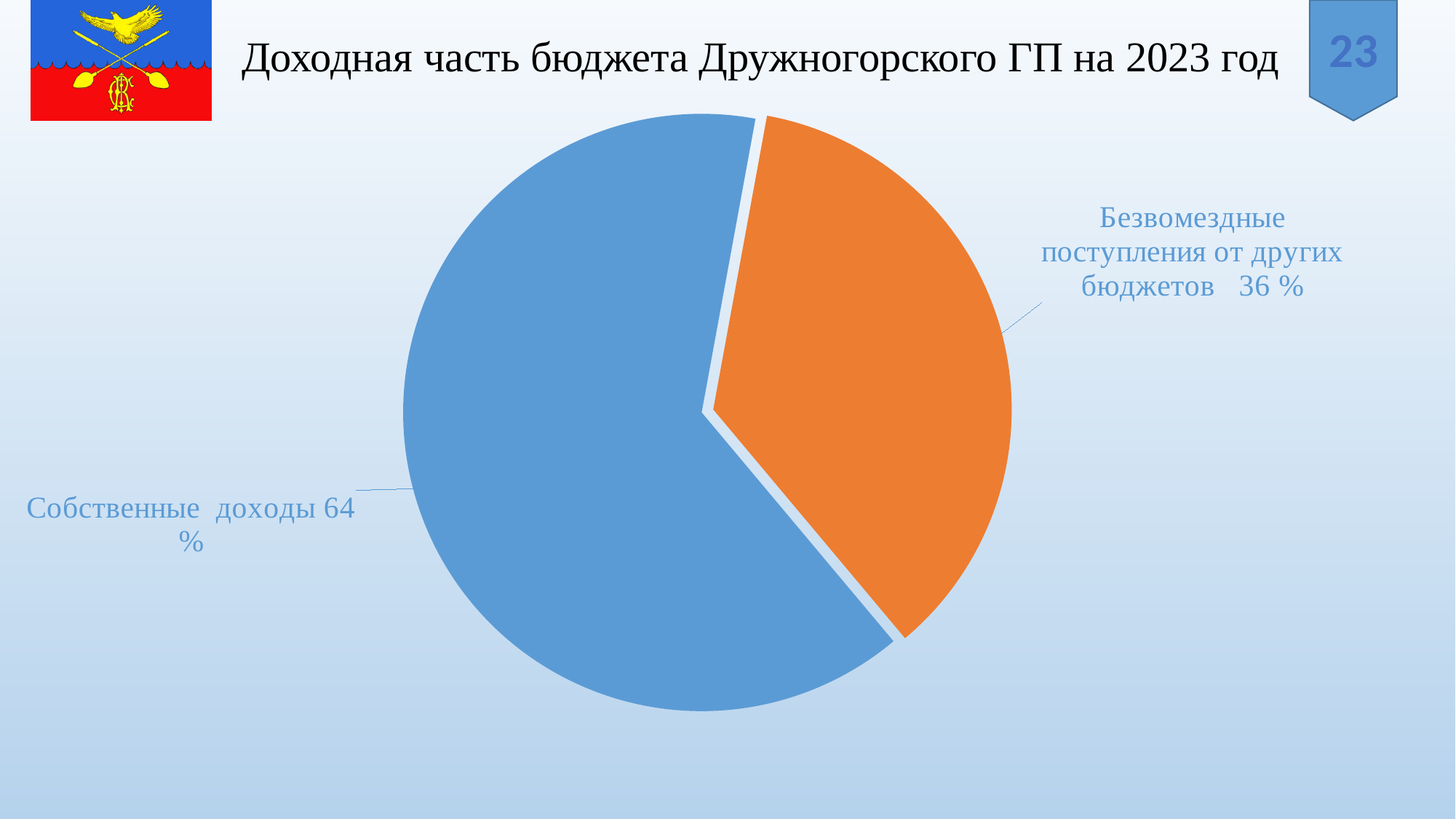
What colour is the slice for "Безвомездные поступления от других бюджетов"? orange What is the difference in percentage points between "Собственные доходы" and "Безвомездные поступления от других бюджетов"? 28 Which slice of the pie is the smallest? Безвомездные поступления от других бюджетов What is the title of the slide containing the pie chart? Доходная часть бюджета Дружногорского ГП на 2023 год What share of the pie does "Безвомездные поступления от других бюджетов" represent? 36 % Is the share for "Собственные доходы" greater or less than 50%? greater Which slice of the pie is the largest? Собственные доходы How many slices does the pie chart have? 2 What kind of chart is shown on the slide? pie chart What share of the pie does "Собственные доходы" represent? 64 % Which is larger: "Собственные доходы" or "Безвомездные поступления от других бюджетов"? Собственные доходы